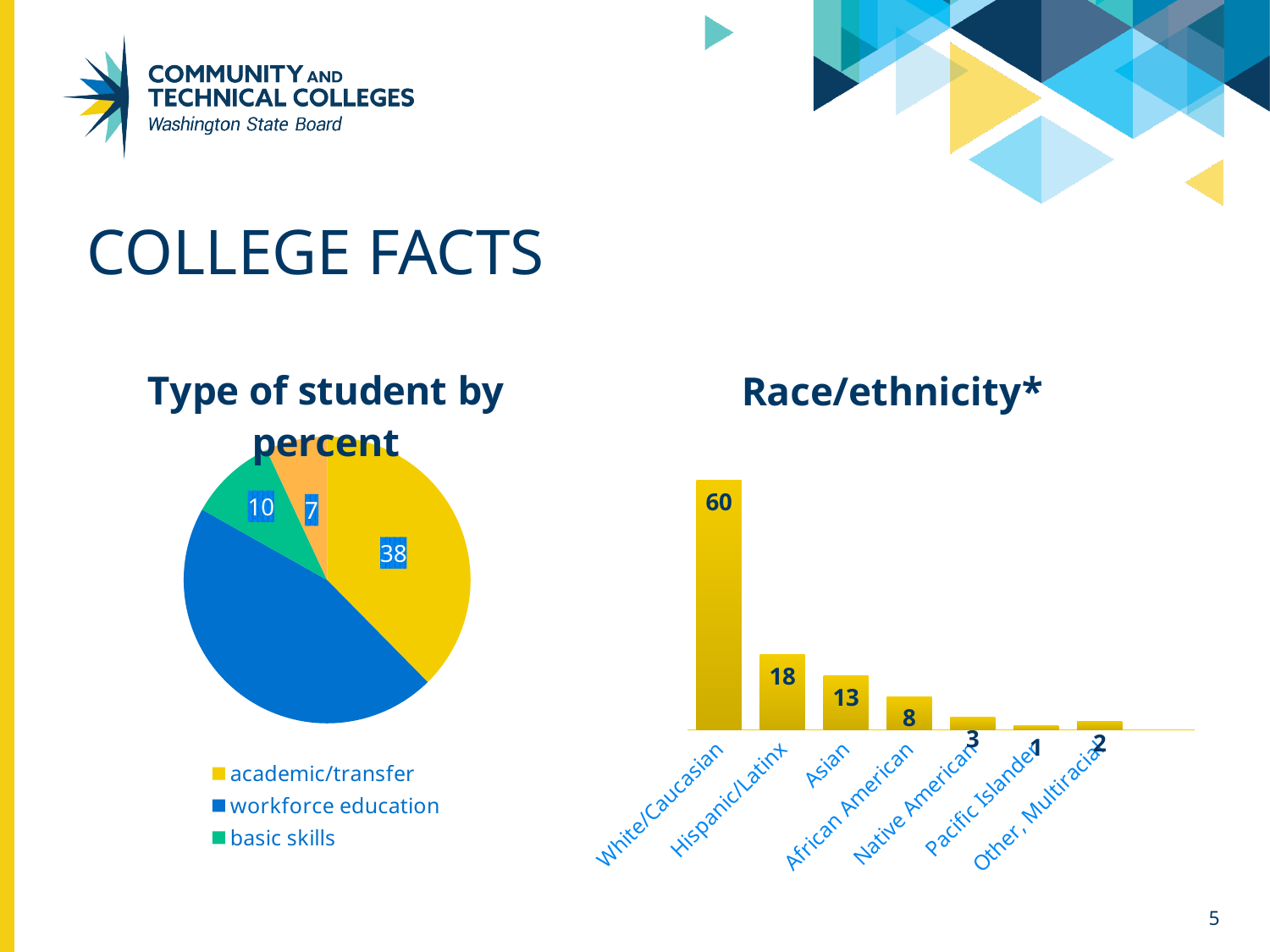
What kind of chart is the Type of student by percent chart? pie chart In the Type of student by percent chart, what is the value for basic skills? 10 In the Type of student by percent chart, what is the value for academic/transfer? 38 In the Race/ethnicity* chart, what is the value for Hispanic/Latinx? 18 In the Race/ethnicity* chart, which category has the lowest value? Pacific Islander In the Race/ethnicity* chart, which is larger, the value for Asian or the value for African American? Asian How many categories are shown in the Race/ethnicity* chart? 7 How many entries does the legend of the Type of student by percent chart list? 3 What kind of chart is the Race/ethnicity* chart? bar chart In the Race/ethnicity* chart, what is the value for White/Caucasian? 60 In the Race/ethnicity* chart, which category has the highest value? White/Caucasian In the Race/ethnicity* chart, what is the difference between the values for White/Caucasian and Hispanic/Latinx? 42